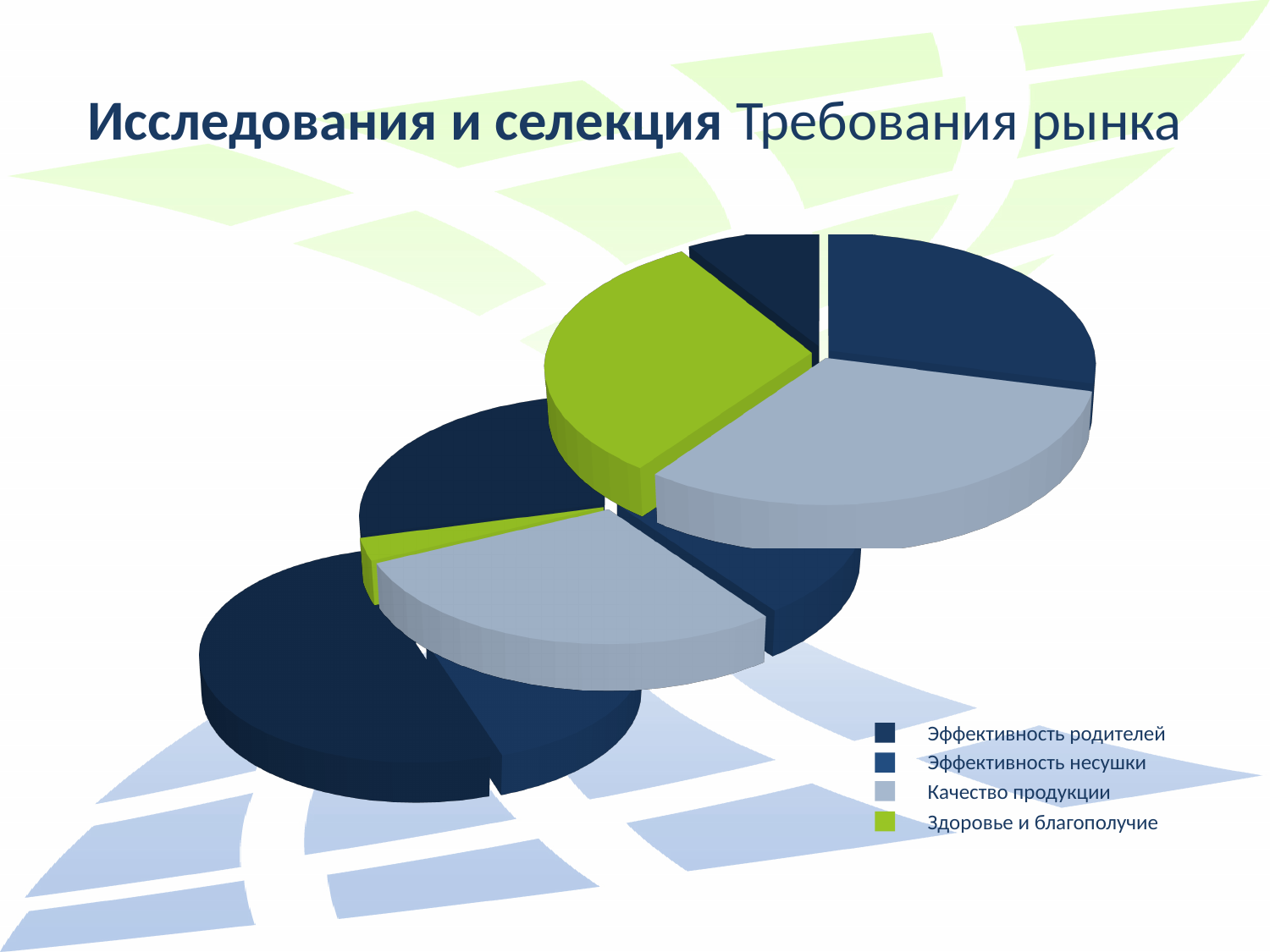
How many entries does the legend list? 4 How many slices are visible in the bottom-left pie chart? 2 Which legend entry is shown in light grey-blue? Качество продукции In the top-right pie chart, which category has the smallest slice? Эффективность родителей In the top-right pie chart, which slice is larger: Здоровье и благополучие or Эффективность родителей? Здоровье и благополучие What kind of chart is shown on the slide? pie chart In the bottom-left pie chart, which category has the largest slice? Эффективность родителей Which legend entry is shown in green? Здоровье и благополучие How many pie charts are shown on the slide? 3 In the middle pie chart, which category has the smallest slice? Здоровье и благополучие In the middle pie chart, which slice is larger: Качество продукции or Эффективность несушки? Эффективность несушки